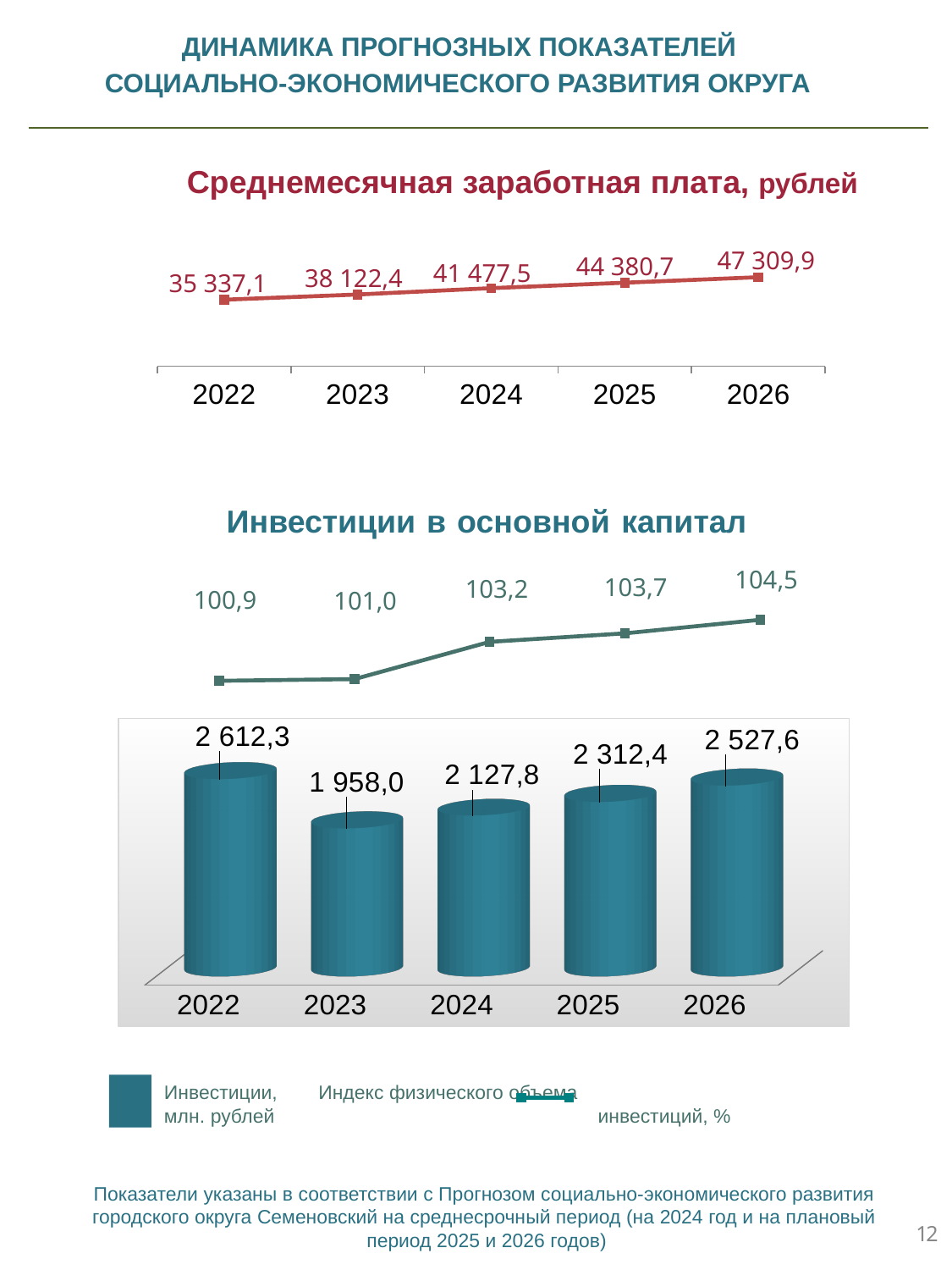
In the chart 'Инвестиции в основной капитал', which year has the lowest bar (Инвестиции, млн. рублей)? 2023 In the chart 'Инвестиции в основной капитал', what is the difference between the bars for 2022 and 2023 (Инвестиции, млн. рублей)? 654,3 In the chart 'Среднемесячная заработная плата, рублей', do the values rise or fall from 2022 to 2026? rise In the chart 'Инвестиции в основной капитал', is the bar for 2024 or the bar for 2026 larger? 2026 In the chart 'Среднемесячная заработная плата, рублей', what is the value for 2024? 41 477,5 In the chart 'Инвестиции в основной капитал', which year has the highest bar (Инвестиции, млн. рублей)? 2022 In the chart 'Инвестиции в основной капитал', how many series does the legend list? 2 In the chart 'Инвестиции в основной капитал', what is the value of 'Индекс физического объема инвестиций, %' for 2026? 104,5 In the chart 'Среднемесячная заработная плата, рублей', which year has the highest value? 2026 In the chart 'Среднемесячная заработная плата, рублей', how many years are plotted? 5 In the chart 'Инвестиции в основной капитал', what is the value of the bar for 2025 (Инвестиции, млн. рублей)? 2 312,4 In the chart 'Среднемесячная заработная плата, рублей', what is the difference between the 2026 and 2022 values? 11 972,8